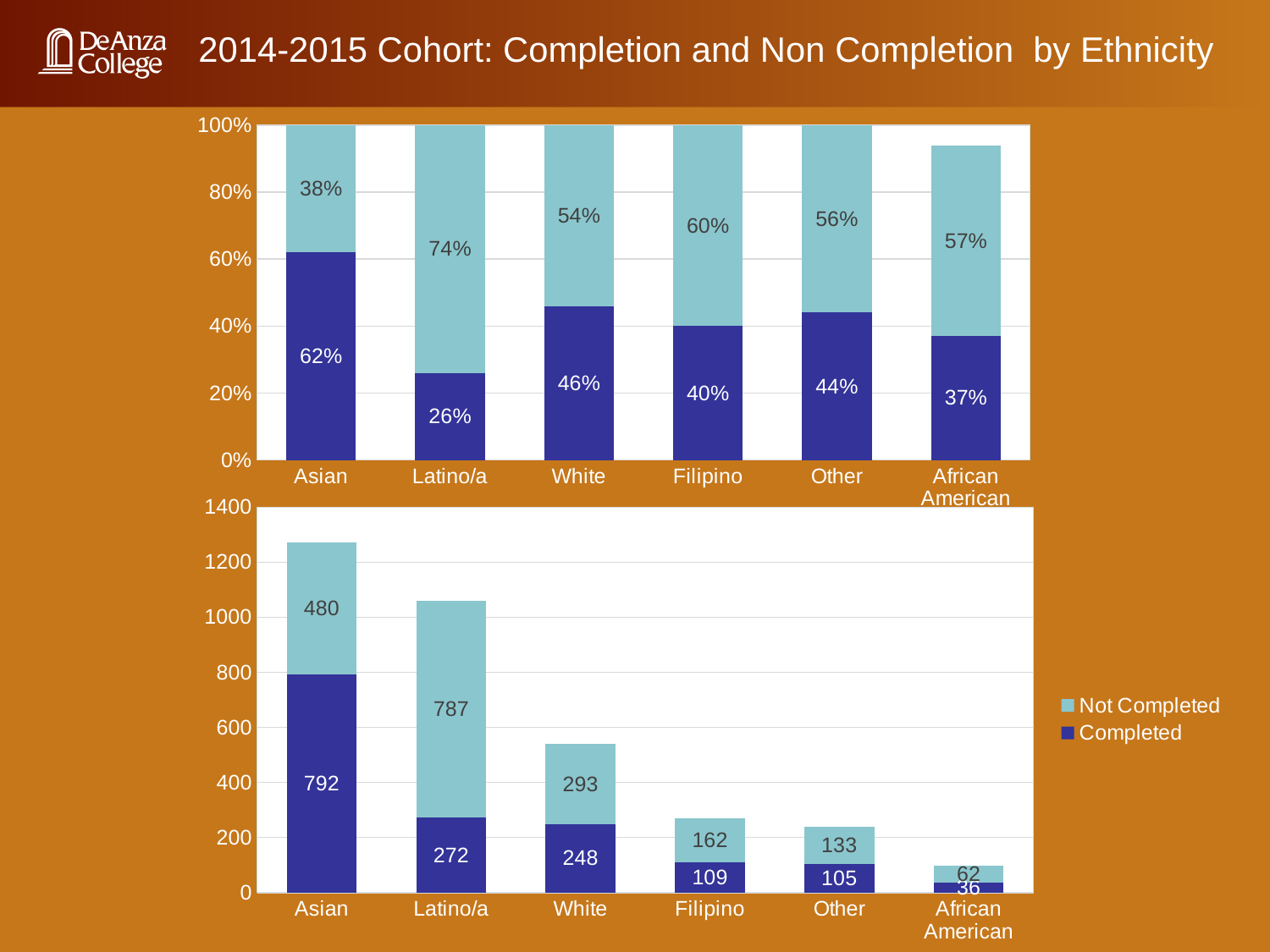
In the top chart (percentages), which ethnicity has the lowest Completed percentage? Latino/a In the bottom chart (counts), is the total bar for White greater or less than 600? less In the top chart (percentages), what is the difference between the Completed percentages for White and Filipino? 6% In the top chart (percentages), what is the Completed percentage for Asian? 62% In the bottom chart (counts), how many African American students are in the Completed group? 36 In the top chart (percentages), what is the Not Completed percentage for Latino/a? 74% In the bottom chart (counts), how many Latino/a students are in the Not Completed group? 787 How many ethnicity categories are shown on the x axis of the bottom chart? 6 In the bottom chart (counts), which is larger: the Completed count for Filipino or the Completed count for Other? Filipino In the bottom chart (counts), what is the total number of Asian students (Completed plus Not Completed)? 1272 How many series does the legend list? 2 In the top chart (percentages), which ethnicity has the highest Completed percentage? Asian